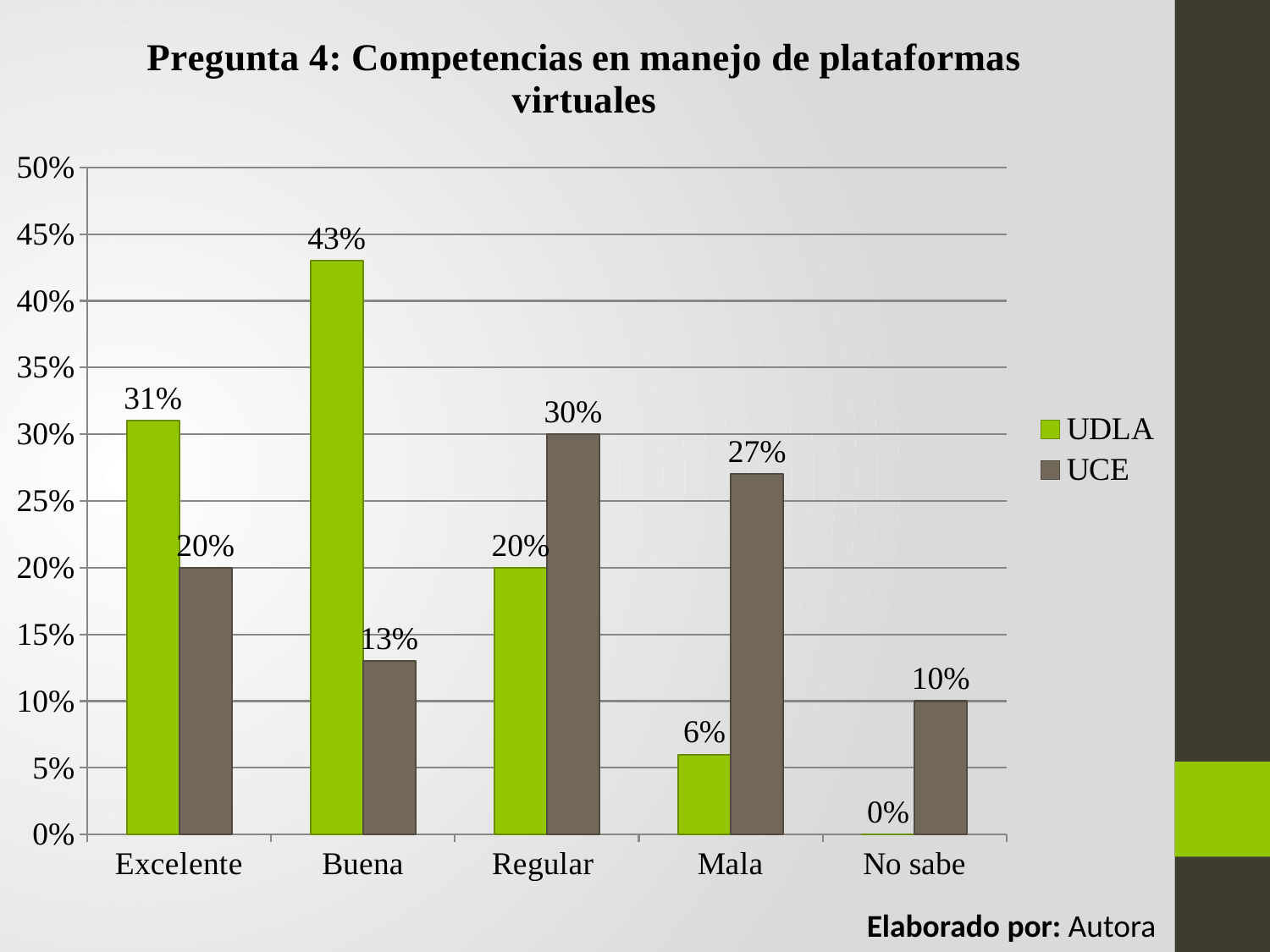
What is the UDLA value for Buena? 43% What is the UCE value for Mala? 27% What kind of chart is shown on the slide? Bar chart What colour are the UDLA bars? Green Which is larger for Mala, the UDLA value or the UCE value? UCE What is the difference between the UDLA and UCE values for Buena? 30% How many series does the legend list? 2 How many categories are shown on the x axis? 5 Which category has the highest UDLA value? Buena What is the UDLA value for No sabe? 0% Which category has the lowest UCE value? No sabe What is the UCE value for Regular? 30%